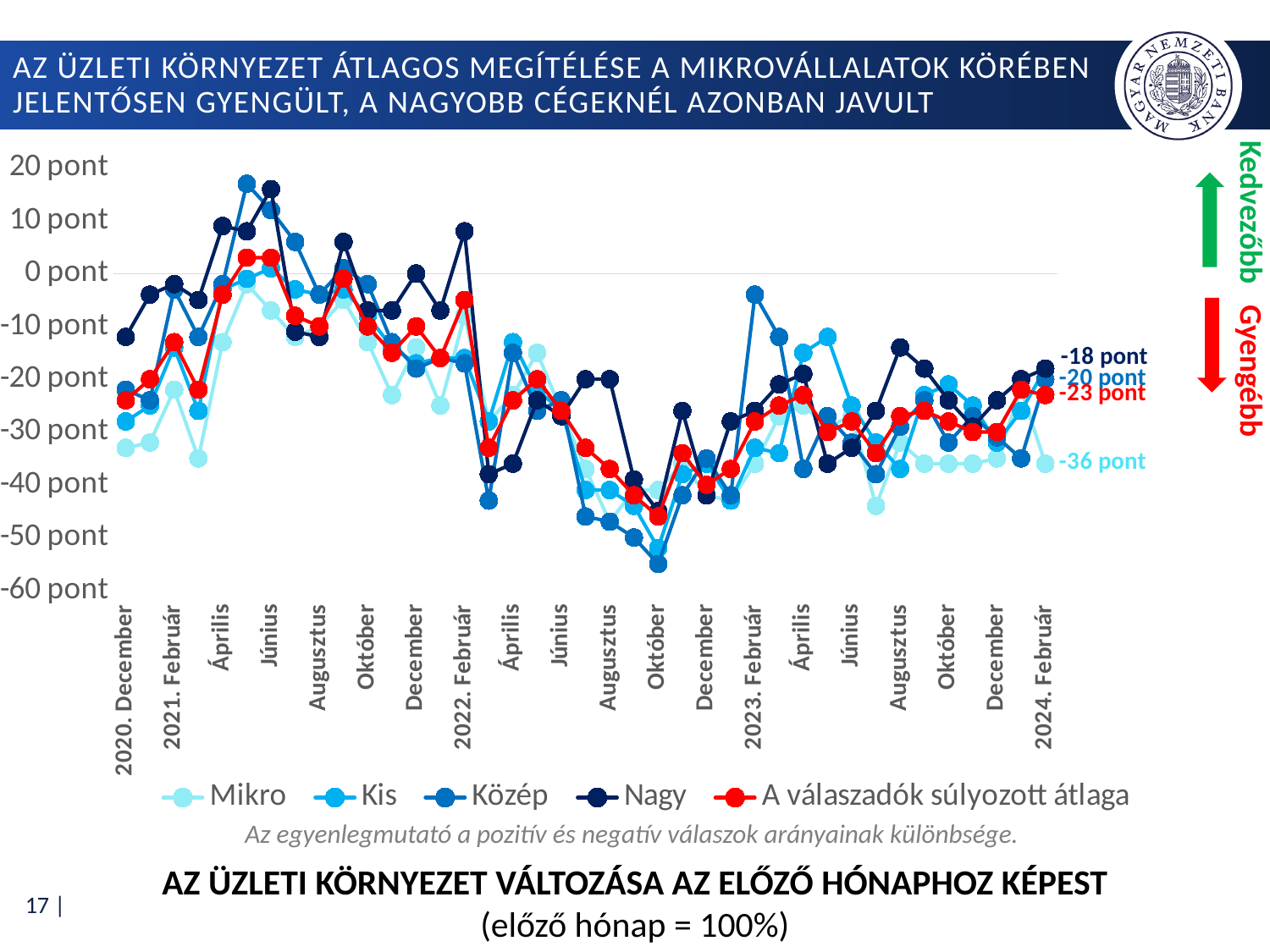
Is the value of the Nagy series in 2022. Október greater or less than -50 pont? greater How many series does the legend list? 5 What is the difference between the Nagy and Mikro values in 2024. Február? 18 pont Which series is drawn in red? A válaszadók súlyozott átlaga What is the value of 'A válaszadók súlyozott átlaga' in 2024. Február? -23 pont What kind of chart is shown on the slide? line chart What is the value of the Mikro series in 2024. Február? -36 pont Does the 'A válaszadók súlyozott átlaga' series rise or fall between 2021. Június and 2022. Október? fall What is the value of the Közép series in 2024. Február? -20 pont What is the value of the Nagy series in 2024. Február? -18 pont Which series has the lowest value in 2024. Február? Mikro